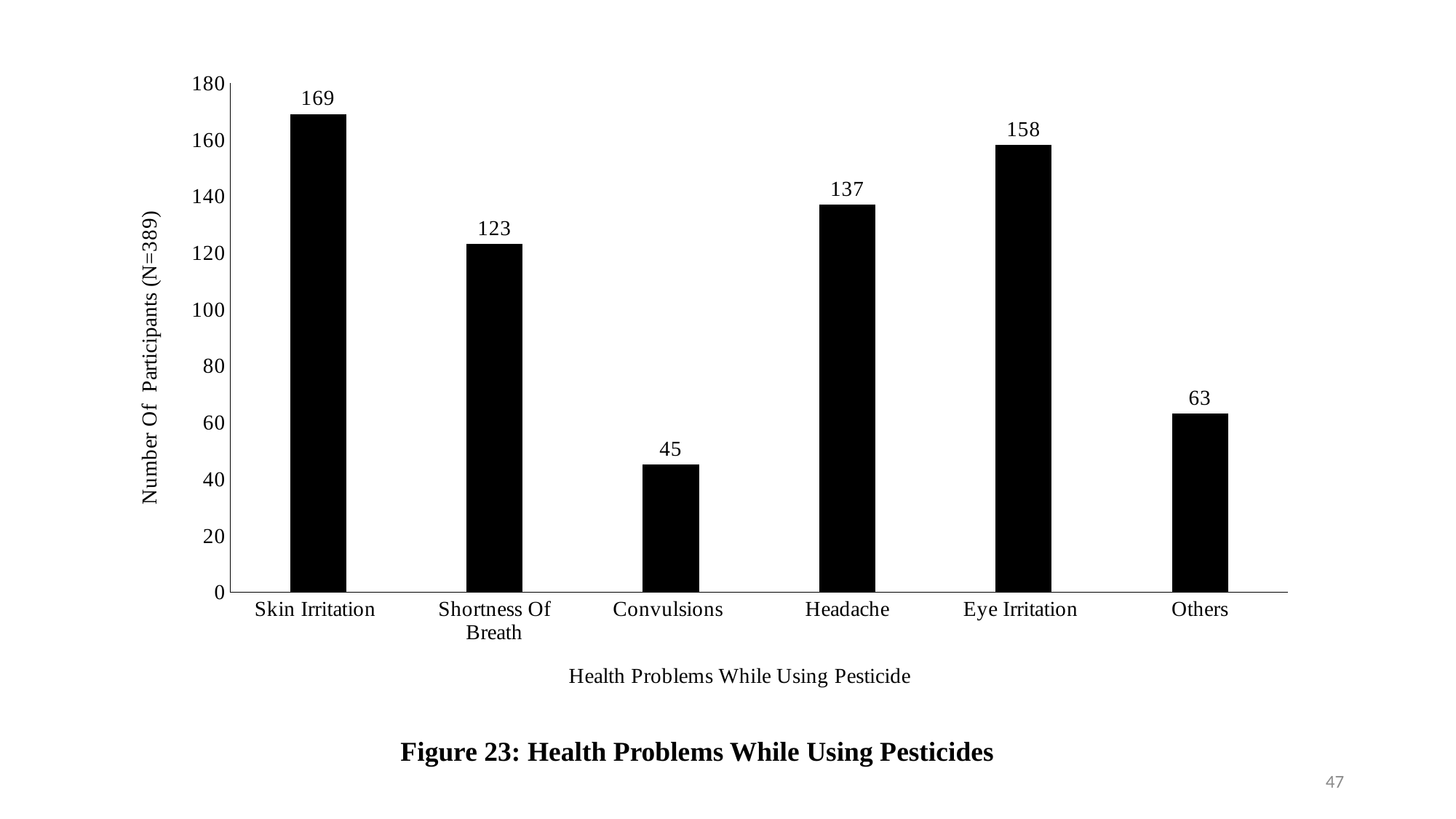
Which is larger, the value for Shortness Of Breath or the value for Headache? Headache What is the difference between the values for Skin Irritation and Eye Irritation? 11 What is the difference between the values for Headache and Others? 74 What value is shown for Eye Irritation? 158 Which health problem has the highest number of participants? Skin Irritation Which health problem has the lowest number of participants? Convulsions Is the value for Others greater or less than 80? less How many health problem categories are shown on the x axis? 6 What is the number of participants for Convulsions? 45 What kind of chart is shown on the slide? bar chart How many participants reported skin irritation? 169 What is the label of the y axis? Number Of Participants (N=389)